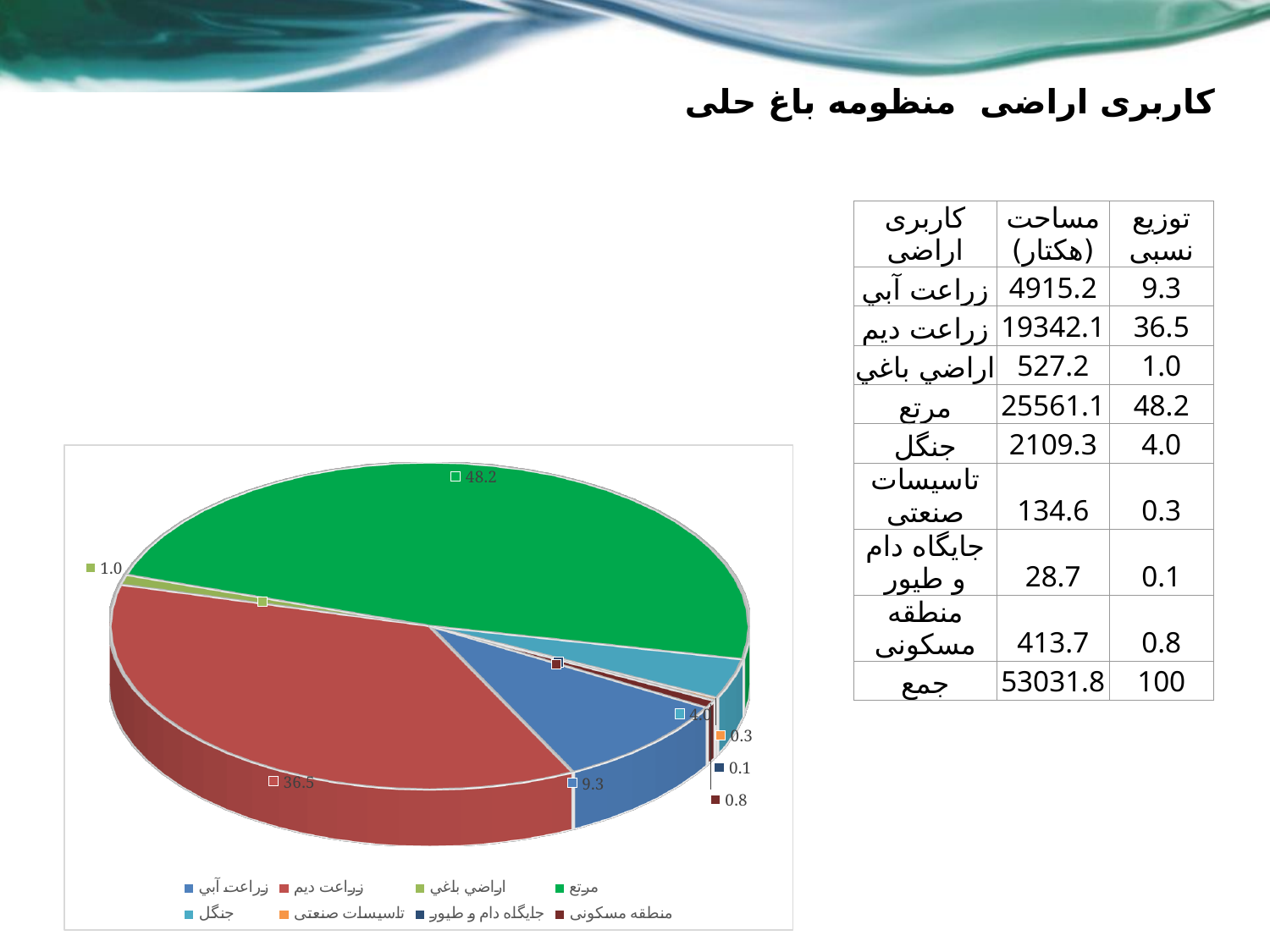
What is the value shown for زراعت آبی in the pie chart? 9.3 Which category has the smallest slice in the pie chart? جایگاه دام و طیور Which category has the largest slice in the pie chart? مرتع What is the value shown for جنگل in the pie chart? 4.0 What is the value shown for زراعت دیم in the pie chart? 36.5 What is the difference between the values for مرتع and زراعت دیم in the pie chart? 11.7 What is the value shown for مرتع in the pie chart? 48.2 Which is larger in the pie chart, the value for زراعت آبی or the value for جنگل? زراعت آبی What kind of chart is shown on the slide? pie chart How many entries does the pie chart's legend list? 8 What colour is the slice for مرتع in the pie chart? green How many slices does the pie chart have? 8